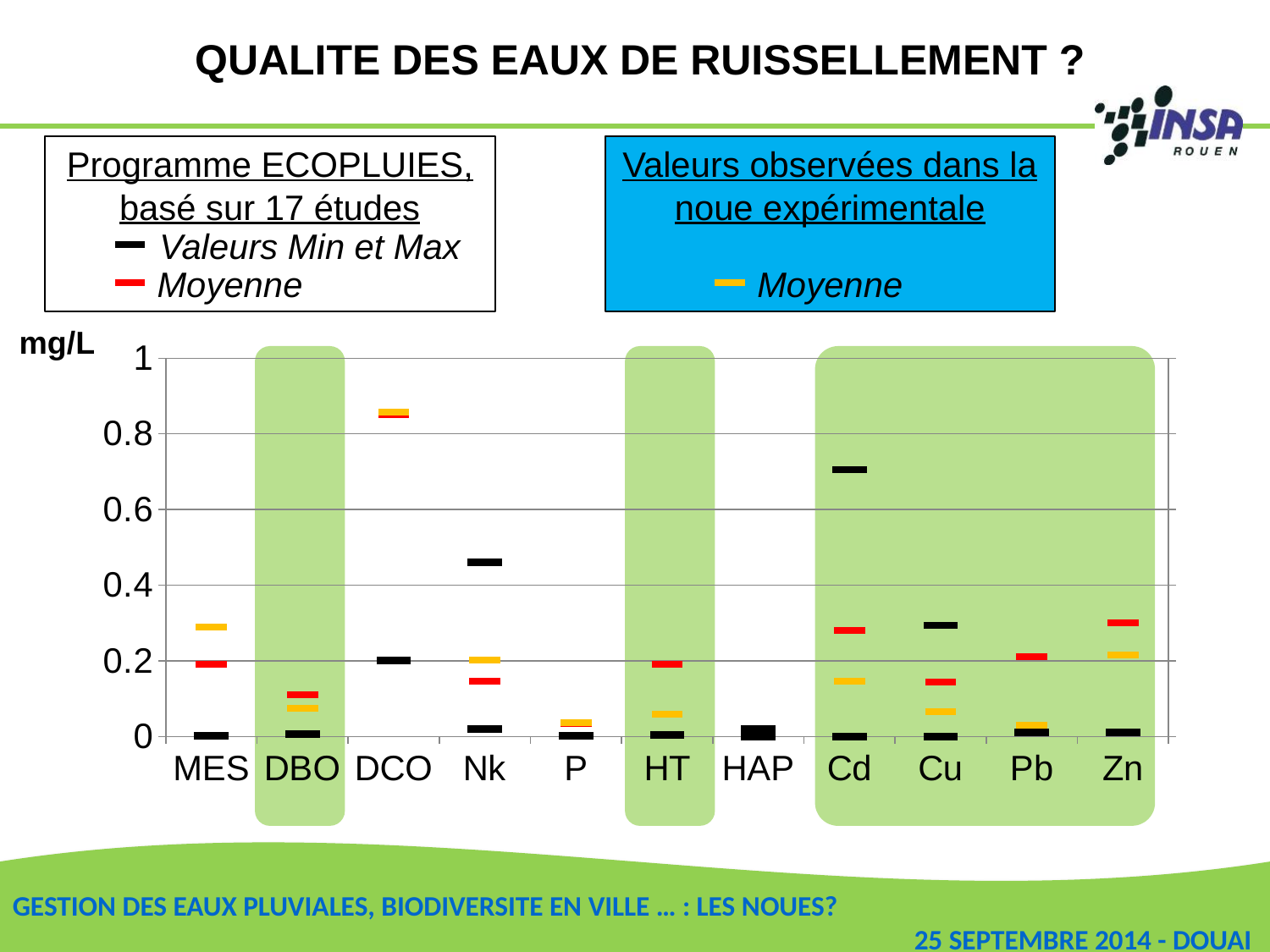
Is the upper black marker for Nk greater or less than 0.4? greater According to the legend, what do the black markers represent? Valeurs Min et Max Which is larger, the red marker for Zn or the red marker for Cu? Zn Is the red (Moyenne) marker for DCO greater or less than 0.8? greater Which is larger, the yellow marker for MES or the yellow marker for P? MES Is the upper black marker for Cd greater or less than 0.6? greater Which category has the highest red (Moyenne) marker? DCO What unit is shown for the y axis of the chart? mg/L Which category has the highest black (Min/Max) marker? Cd How many categories are shown on the x axis of the chart? 11